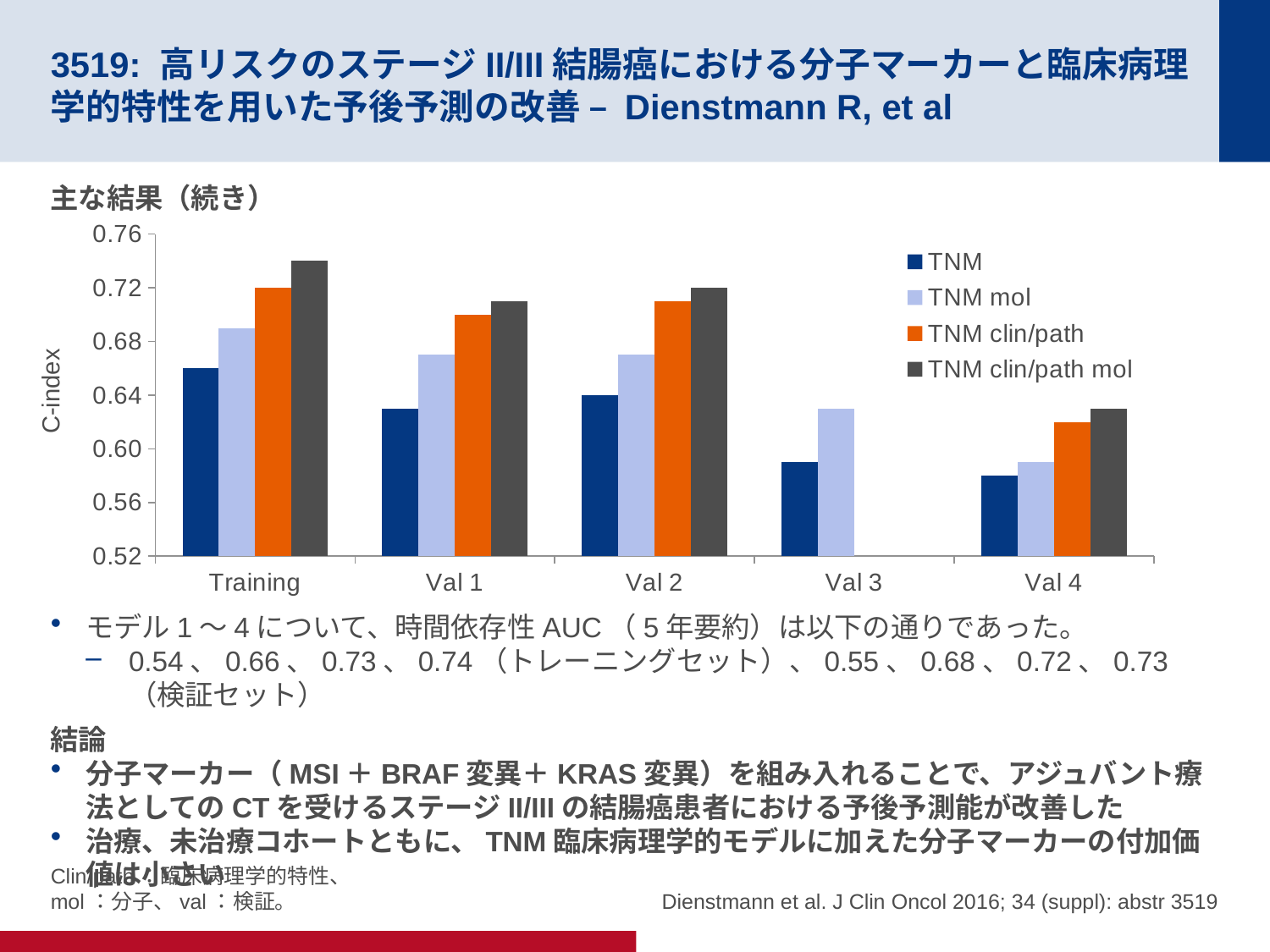
How many series does the chart's legend list? 4 What kind of chart is shown on the slide? bar chart Which series has the lowest bar in the Val 4 category? TNM What is the label of the y axis? C-index Is the value for TNM in the Val 4 category greater or less than 0.60? less Is the value for TNM mol in the Val 3 category greater or less than 0.60? greater How many bars are plotted in the Val 3 category? 2 How many categories are shown on the x axis of the chart? 5 Is the value for TNM clin/path in the Val 1 category greater or less than 0.68? greater Which series has the highest bar in the Training category? TNM clin/path mol Which is larger: the TNM value for Training or the TNM value for Val 1? Training